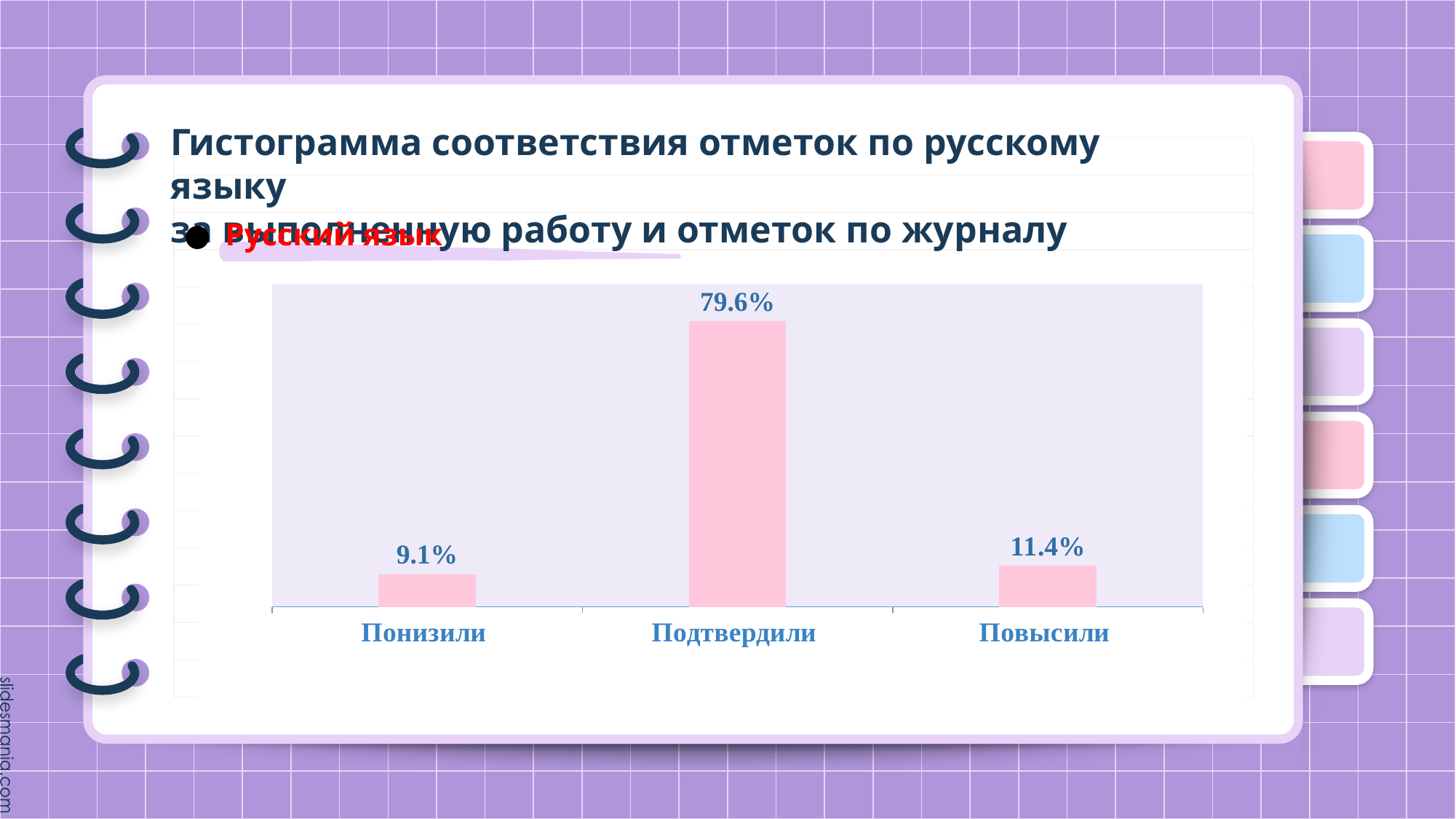
Which is larger, the value for Повысили or the value for Понизили? Повысили What is the total of the three values shown on the chart? 100.1% Which category has the lowest value? Понизили What kind of chart is shown on the slide? Bar chart What is the value for Подтвердили? 79.6% Which category has the highest value? Подтвердили What is the value for Понизили? 9.1% What colour are the bars in the chart? Pink What is the value for Повысили? 11.4% How many categories are shown on the chart? 3 What is the difference between the values for Подтвердили and Повысили? 68.2% What is the difference between the values for Повысили and Понизили? 2.3%